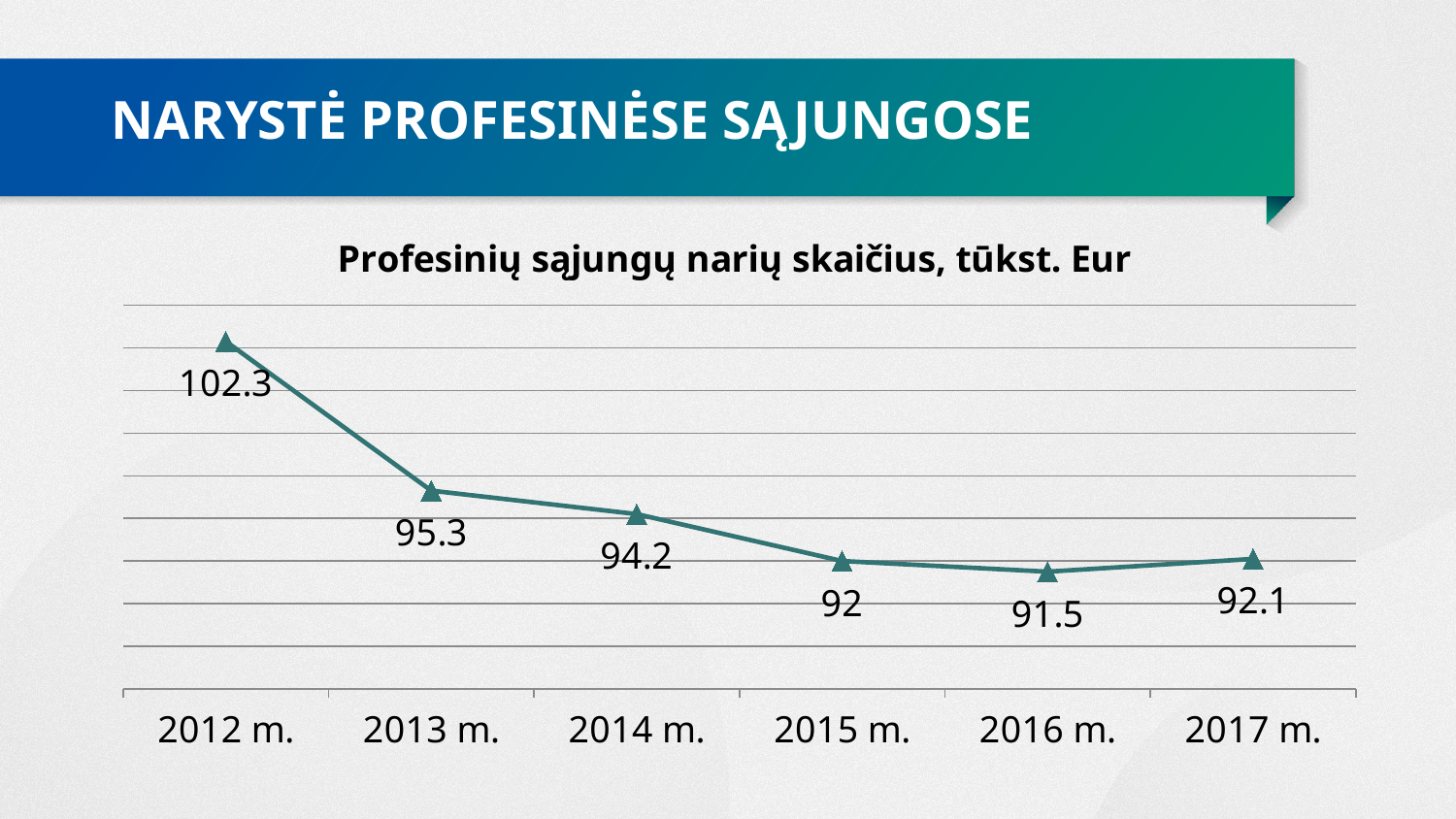
Do the values generally rise or fall from 2012 m. to 2016 m.? fall How many years are plotted on the chart? 6 What is the value for 2014 m.? 94.2 What is the value for 2012 m.? 102.3 Which year has the lowest value? 2016 m. Which year has the highest value? 2012 m. What is the difference between the values for 2012 m. and 2013 m.? 7 What is the difference between the values for 2015 m. and 2017 m.? 0.1 What kind of chart is shown on the slide? line chart What is the value for 2016 m.? 91.5 What is the title of the chart? Profesinių sąjungų narių skaičius, tūkst. Eur Which is larger, the value for 2013 m. or the value for 2014 m.? 2013 m.